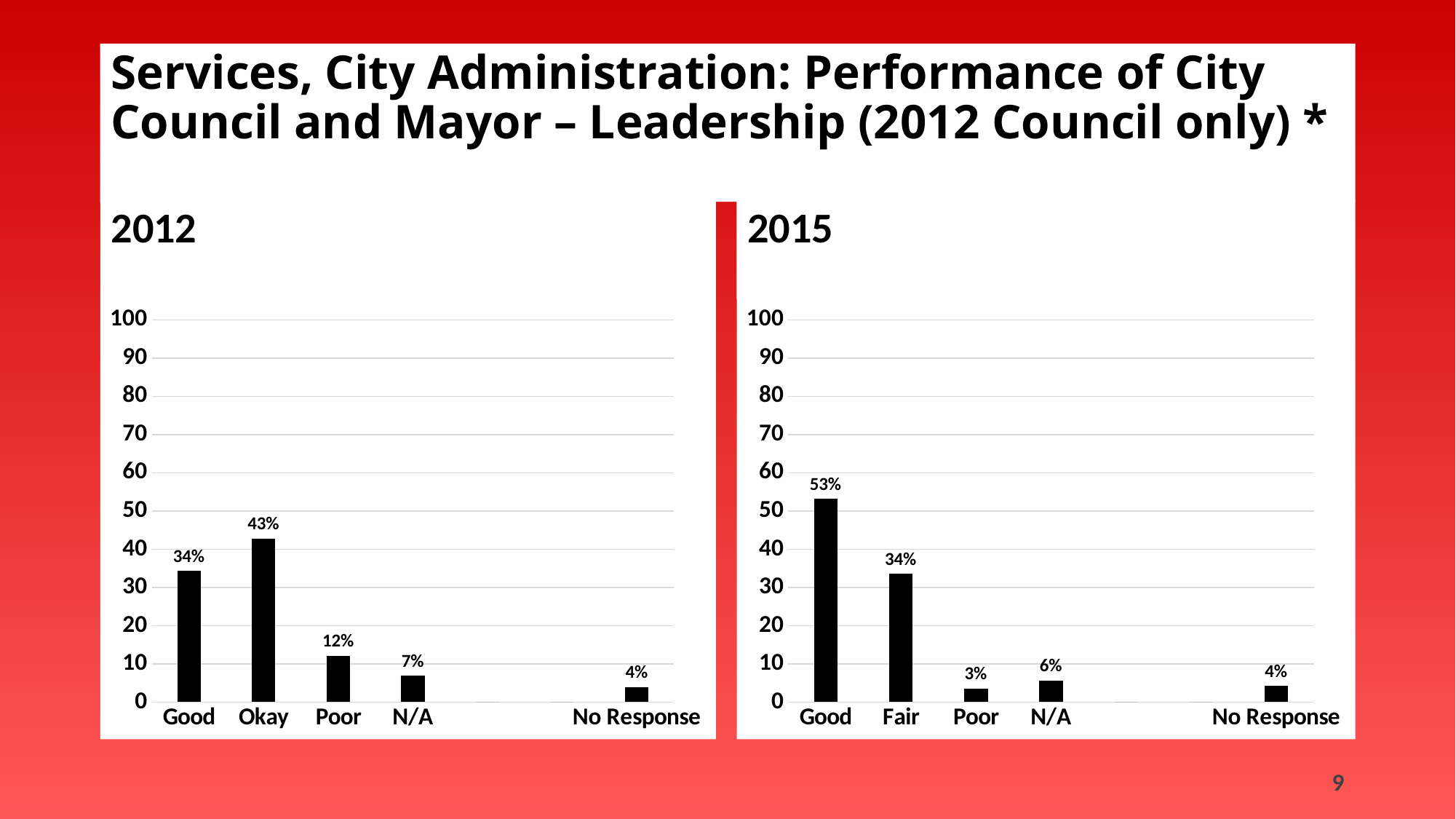
In the 2012 chart, what is the value for N/A? 7% In the 2015 chart, what is the difference between Good and Fair? 19% In the 2012 chart, which category has the highest value? Okay What kind of chart is the 2015 chart? bar chart In the 2015 chart, what is the value for Poor? 3% In the 2012 chart, is the value for Good greater or less than 30? greater In the 2015 chart, what is the value for Good? 53% In the 2015 chart, what is the value for No Response? 4% Which is larger: Good in the 2012 chart or Good in the 2015 chart? Good in the 2015 chart In the 2015 chart, which category has the lowest value? Poor In the 2012 chart, what is the difference between Okay and Poor? 31% In the 2012 chart, what is the value for Okay? 43%